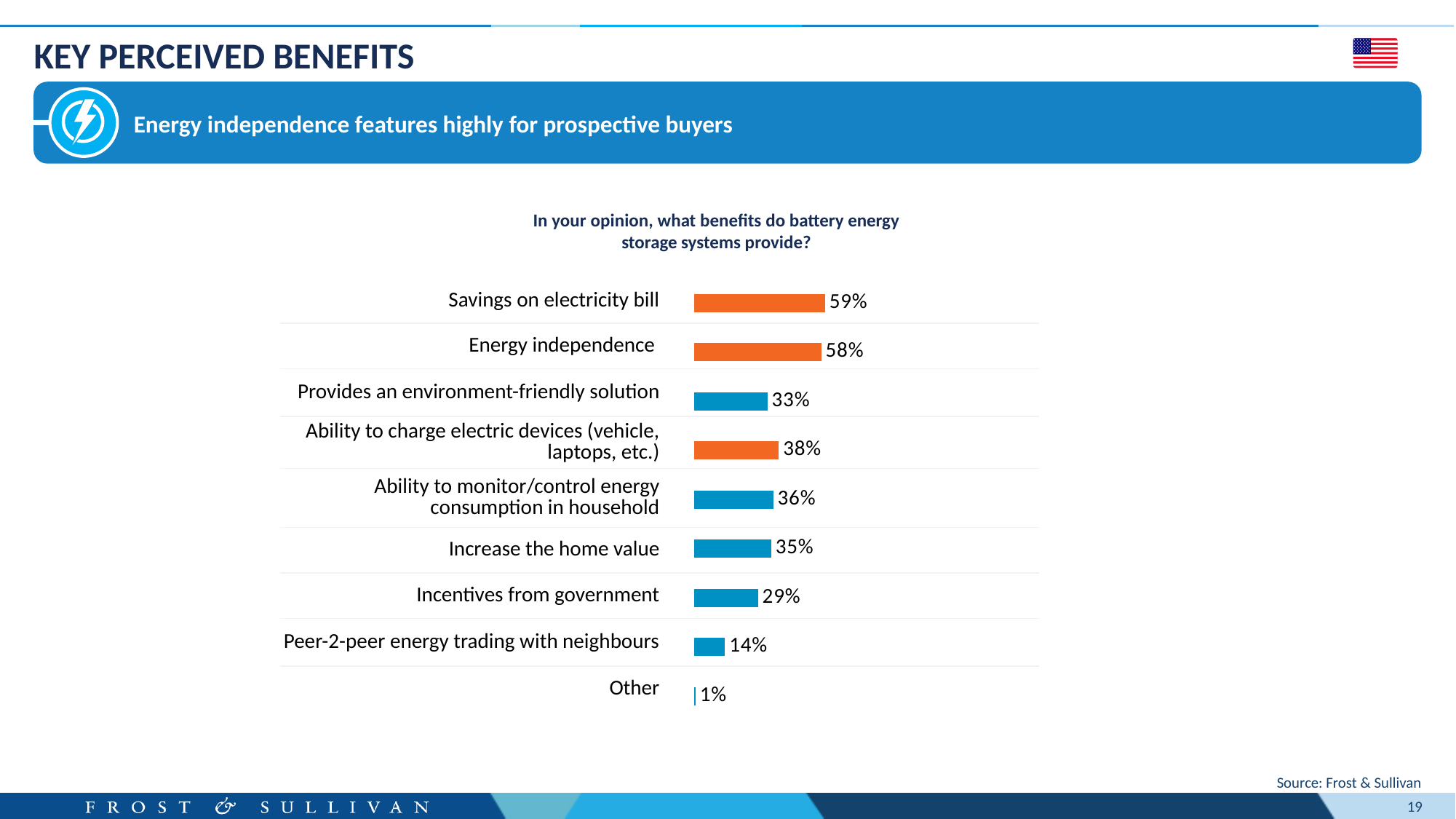
Which is larger: 'Increase the home value' or 'Incentives from government'? Increase the home value What is the value for 'Energy independence'? 58% Which category has the lowest value? Other What percentage of respondents cited 'Savings on electricity bill' as a benefit? 59% What kind of chart is shown on the slide? Bar chart What question is the chart titled with? In your opinion, what benefits do battery energy storage systems provide? How many categories are shown in the chart? 9 What is the value for 'Peer-2-peer energy trading with neighbours'? 14% What is the difference between 'Ability to charge electric devices (vehicle, laptops, etc.)' and 'Provides an environment-friendly solution'? 5% Which category has the highest value? Savings on electricity bill What is the value for 'Incentives from government'? 29% What is the difference between 'Savings on electricity bill' and 'Energy independence'? 1%